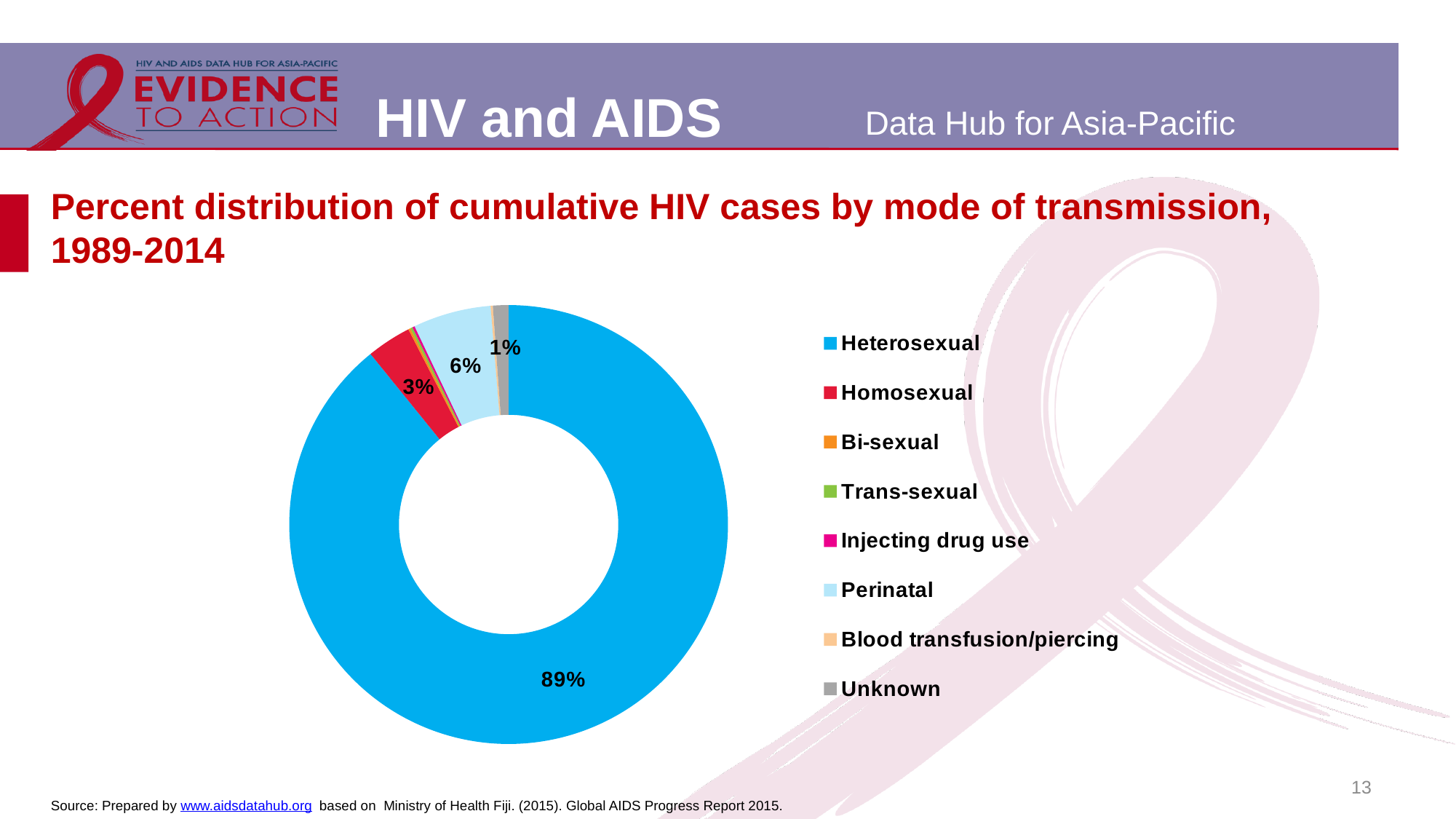
What is the title of the chart on the slide? Percent distribution of cumulative HIV cases by mode of transmission, 1989-2014 How many percentage points larger is the Perinatal share than the Homosexual share? 3 percentage points What percentage of cumulative HIV cases has an Unknown mode of transmission? 1% How many percentage points larger is the Heterosexual share than the Perinatal share? 83 percentage points What colour represents Heterosexual transmission in the chart? Blue What percentage of cumulative HIV cases is attributed to Perinatal transmission? 6% How many modes of transmission are listed in the chart legend? 8 Which accounts for a larger share of cases, Perinatal or Homosexual transmission? Perinatal What type of chart is used to show the distribution of HIV cases by mode of transmission? Pie (doughnut) chart What percentage of cumulative HIV cases is attributed to Homosexual transmission? 3% What percentage of cumulative HIV cases is attributed to Heterosexual transmission? 89% Which mode of transmission accounts for the largest share of cumulative HIV cases? Heterosexual